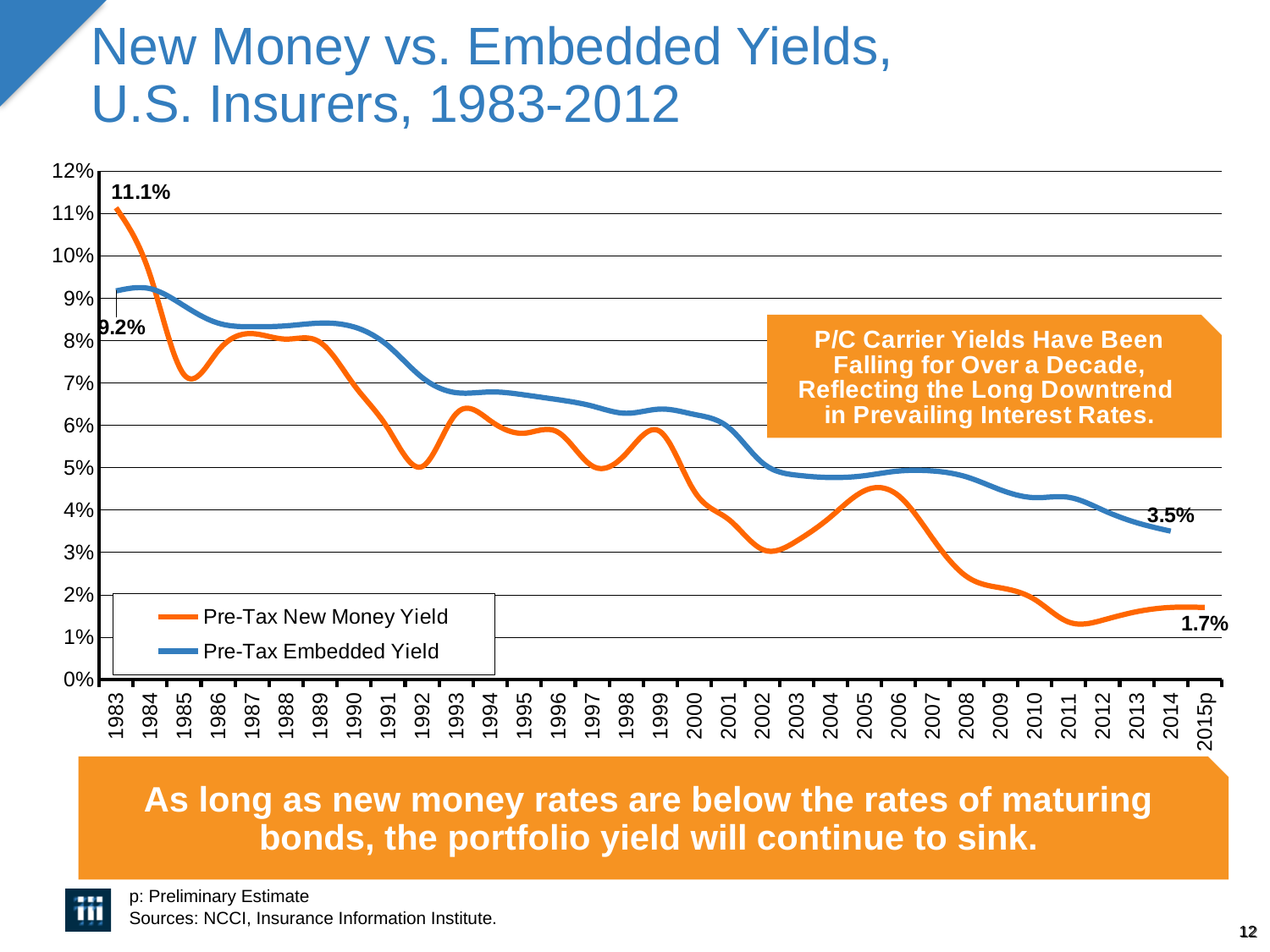
What is the Pre-Tax New Money Yield in 1983? 11.1% Is the Pre-Tax New Money Yield in 2002 greater or less than 4%? less What is the Pre-Tax Embedded Yield in 1983? 9.2% What is the Pre-Tax Embedded Yield in 2014? 3.5% What type of chart is shown on the slide? line chart Which series has the higher value in 2014, Pre-Tax New Money Yield or Pre-Tax Embedded Yield? Pre-Tax Embedded Yield What is the difference between the Pre-Tax New Money Yield and the Pre-Tax Embedded Yield in 1983? 1.9% Which colour is used for the Pre-Tax New Money Yield line? orange What is the Pre-Tax New Money Yield in 2014? 1.7% How many series does the legend list? 2 What is the difference between the Pre-Tax Embedded Yield and the Pre-Tax New Money Yield in 2014? 1.8% Does the Pre-Tax Embedded Yield generally rise or fall from 1983 to 2014? fall